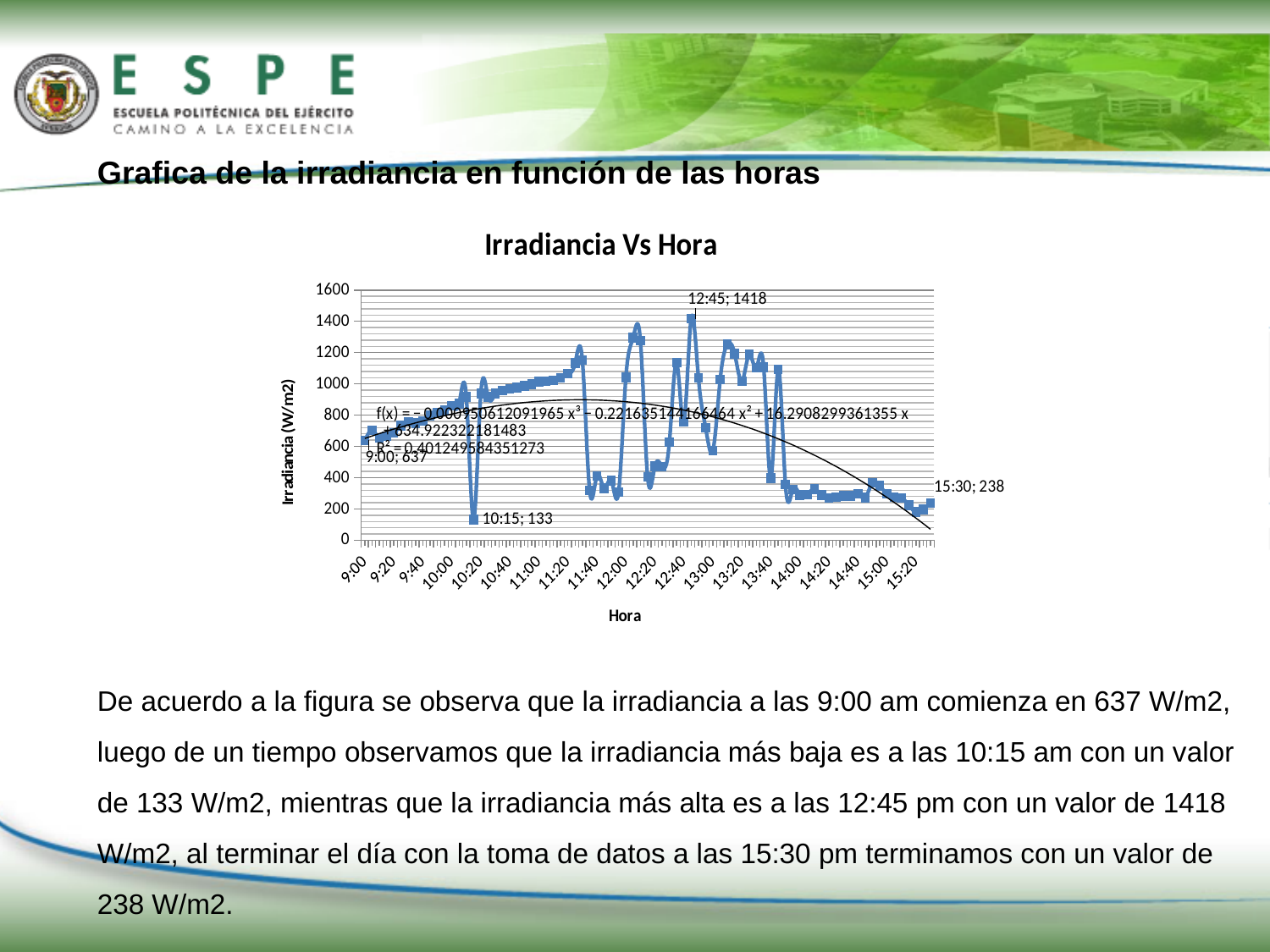
What is the irradiance value labelled at 9:00? 637 What is the title of the chart? Irradiancia Vs Hora What is the irradiance value labelled at 10:15? 133 What is the label of the vertical axis? Irradiancia (W/m2) At what time does the chart show the lowest irradiance value? 10:15 What is the irradiance value labelled at 15:30? 238 Is the irradiance value at 12:45 greater or less than 1400? greater What is the difference between the irradiance at 12:45 and the irradiance at 10:15? 1285 Which is larger, the irradiance at 9:00 or the irradiance at 15:30? 9:00 What type of chart is shown on the slide? line chart What is the irradiance value labelled at 12:45? 1418 At what time does the chart show the highest irradiance value? 12:45